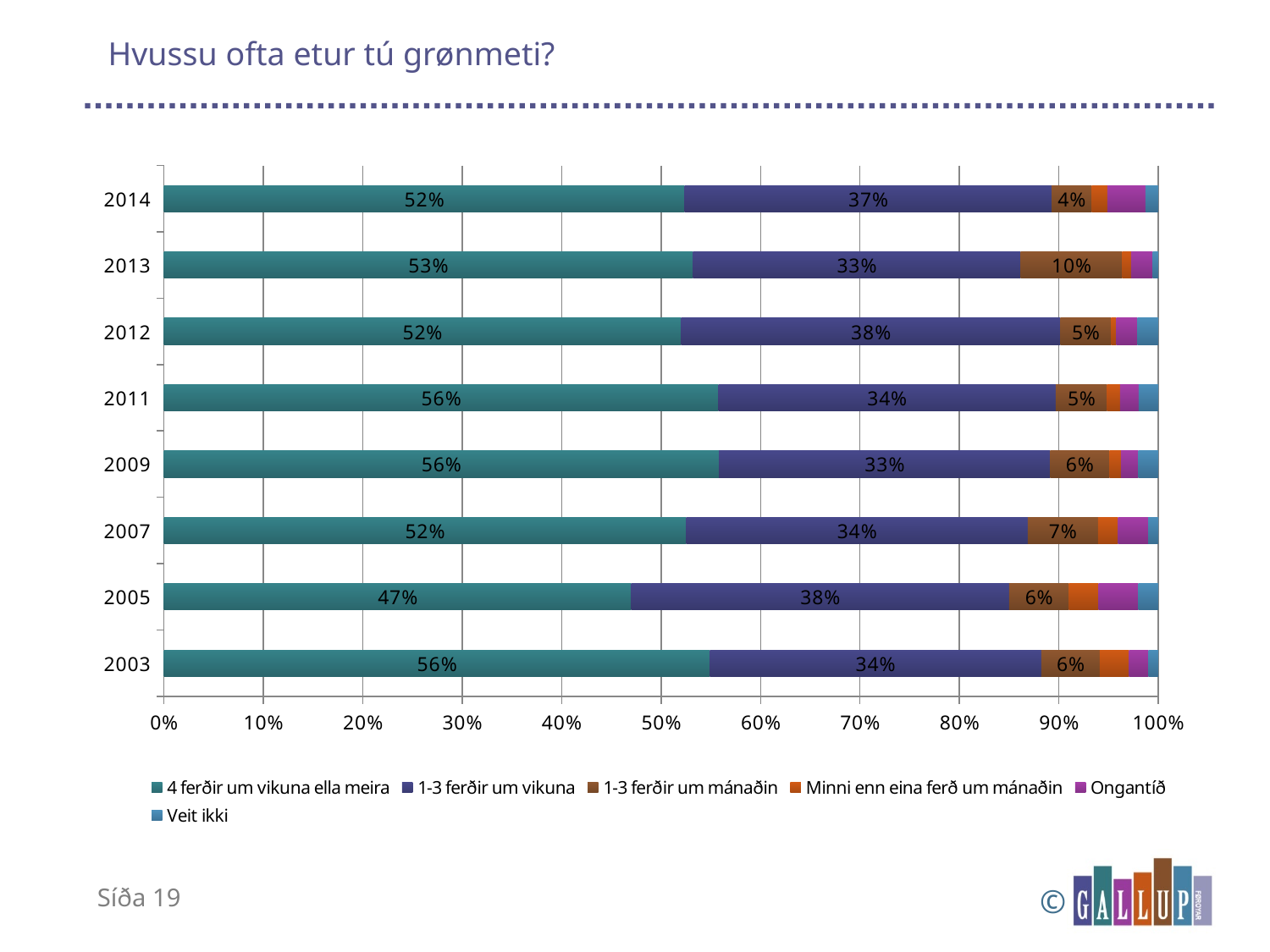
What is the value for "1-3 ferðir um vikuna" in 2005? 38% How many series does the legend list? 6 Which year has the lowest value for "4 ferðir um vikuna ella meira"? 2005 What kind of chart is shown on the slide? Stacked bar chart How many years are shown on the chart? 8 Which year has the lowest value for "1-3 ferðir um mánaðin"? 2014 Which year has the highest value for "1-3 ferðir um mánaðin"? 2013 What percentage of respondents in 2014 answered "4 ferðir um vikuna ella meira"? 52% Is the "4 ferðir um vikuna ella meira" value larger in 2005 or in 2003? 2003 In 2014, what is the difference between the "4 ferðir um vikuna ella meira" value and the "1-3 ferðir um vikuna" value? 15 percentage points What is the value for "4 ferðir um vikuna ella meira" in 2003? 56% What is the value for "1-3 ferðir um mánaðin" in 2013? 10%